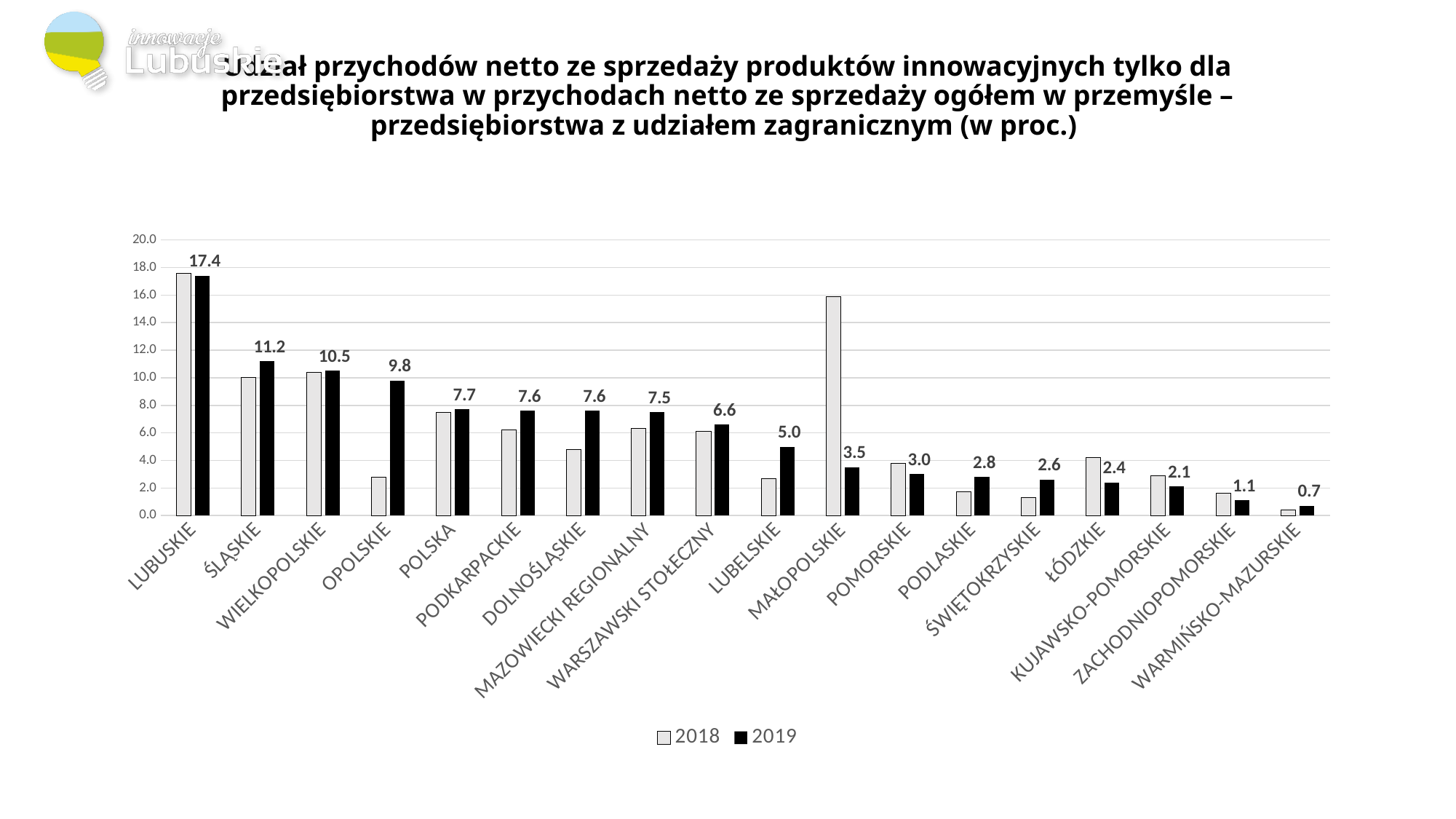
What is the 2019 value for POLSKA? 7.7 Is the 2018 value for MAŁOPOLSKIE greater or less than 14.0? greater Which has the larger 2019 value, OPOLSKIE or POLSKA? OPOLSKIE What is the difference between the 2019 values for LUBUSKIE and ŚLĄSKIE? 6.2 What is the 2019 value for LUBUSKIE? 17.4 How many series does the legend list? 2 What kind of chart is shown on the slide? Bar chart Which category has the highest 2019 value? LUBUSKIE Which category has the lowest 2019 value? WARMIŃSKO-MAZURSKIE How many categories are shown on the x axis? 18 Is the 2018 value for OPOLSKIE greater or less than 4.0? less What is the 2019 value for MAŁOPOLSKIE? 3.5